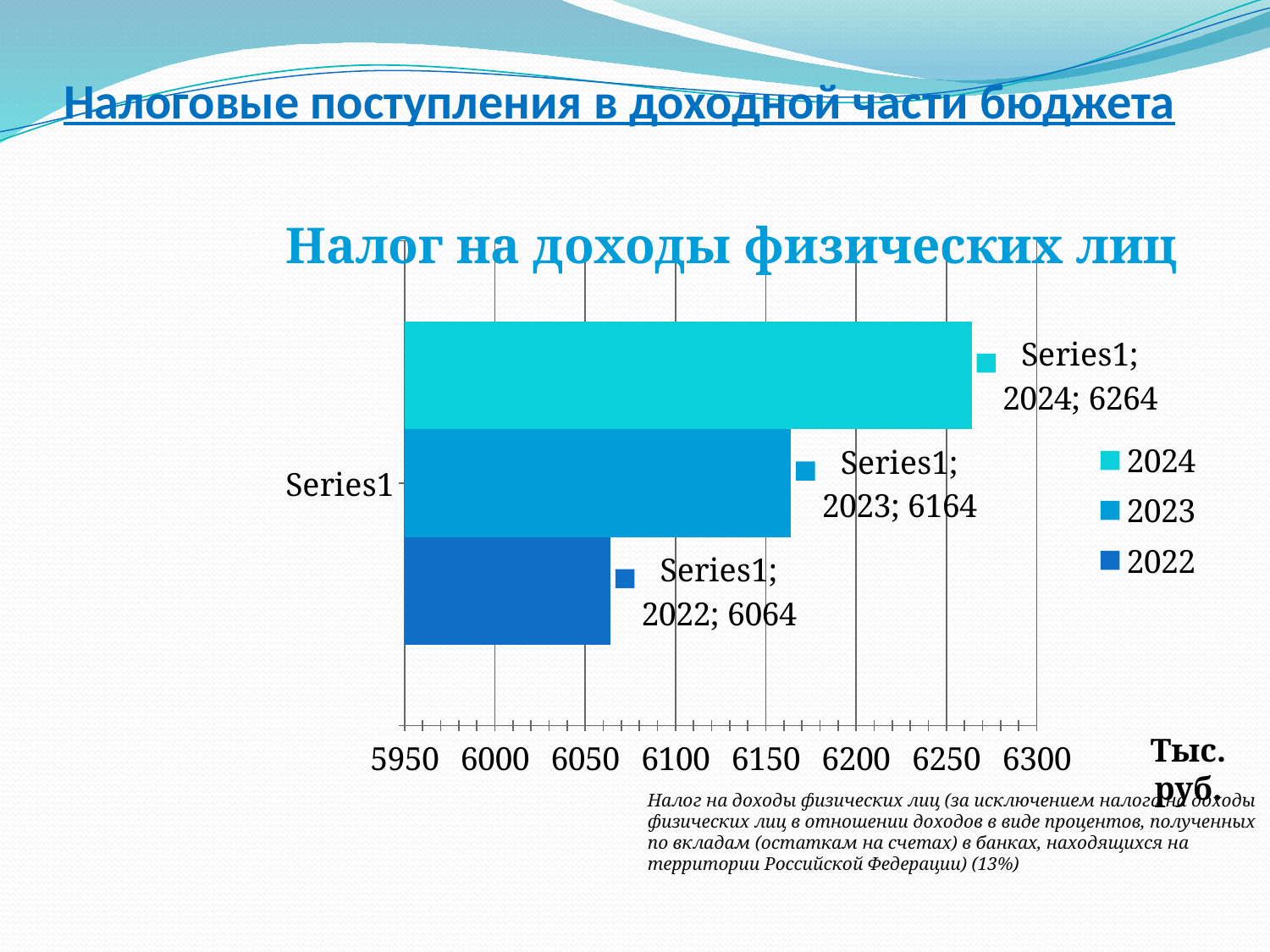
Which is larger, the value for 2023 or the value for 2022? 2023 What kind of chart is shown on the slide? bar chart Which year has the highest value? 2024 Is the value for 2023 greater or less than 6200? less What is the title of the chart? Налог на доходы физических лиц What is the value for 2022? 6064 How many bars are plotted in the chart? 3 What is the difference between the values for 2024 and 2023? 100 Which year has the lowest value? 2022 What is the value for 2023? 6164 What is the value for 2024? 6264 What is the difference between the values for 2024 and 2022? 200